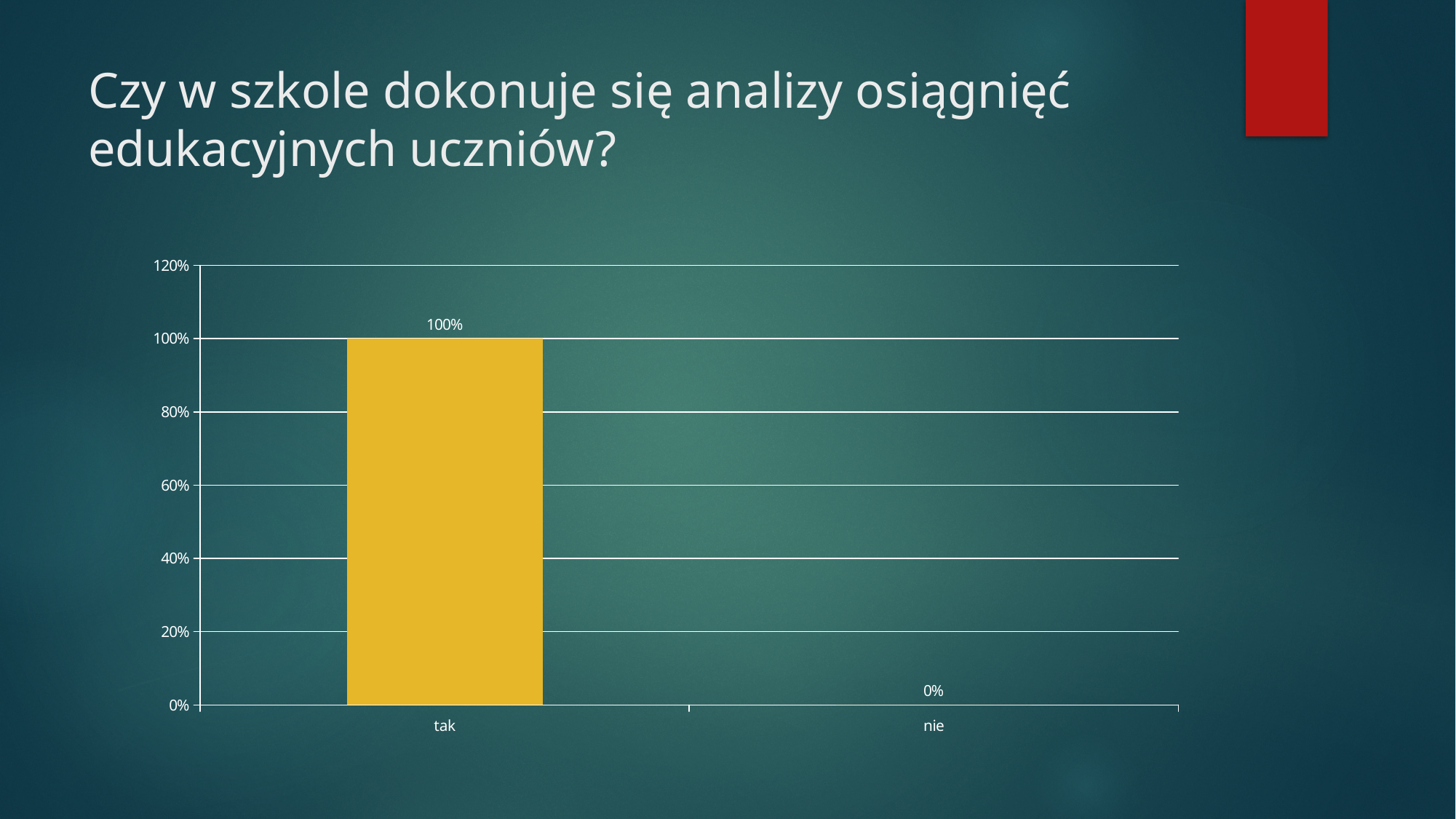
What is the highest value shown on the y axis? 120% Is the value for "tak" greater or less than 80%? greater What is the value for "nie"? 0% Which category has the lowest value? nie What is the value for "tak"? 100% What is the difference between the values for "tak" and "nie"? 100% Which is larger, the value for "tak" or the value for "nie"? tak How many categories are shown on the x axis? 2 What colour is the bar for "tak"? yellow What kind of chart is shown on the slide? bar chart Which category has the highest value? tak